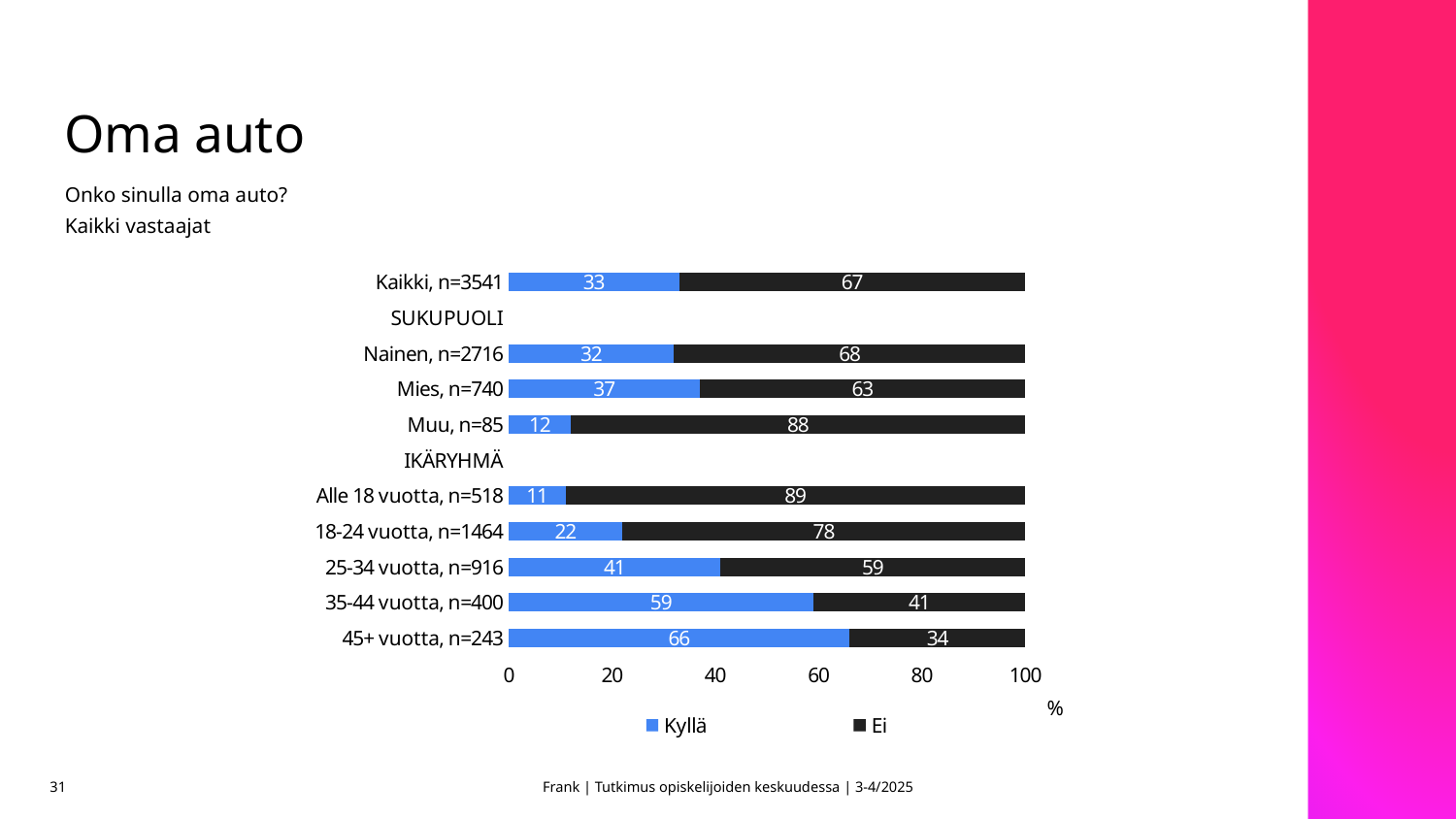
What is the Kyllä value for 35-44 vuotta, n=400? 59 Which category has the lowest Kyllä value? Alle 18 vuotta, n=518 What is the Kyllä value for Kaikki, n=3541? 33 What is the total of the stacked bar for 45+ vuotta, n=243? 100 Which colour represents the Ei series in the chart? Black Do the Kyllä values rise or fall across the age groups from Alle 18 vuotta to 45+ vuotta? Rise What is the difference between the Kyllä values for Mies, n=740 and Nainen, n=2716? 5 What kind of chart is shown on the slide? Stacked bar chart What is the Ei value for Muu, n=85? 88 Which has a larger Ei value, 18-24 vuotta, n=1464 or 25-34 vuotta, n=916? 18-24 vuotta, n=1464 Which category has the highest Kyllä value? 45+ vuotta, n=243 How many series does the legend list? 2